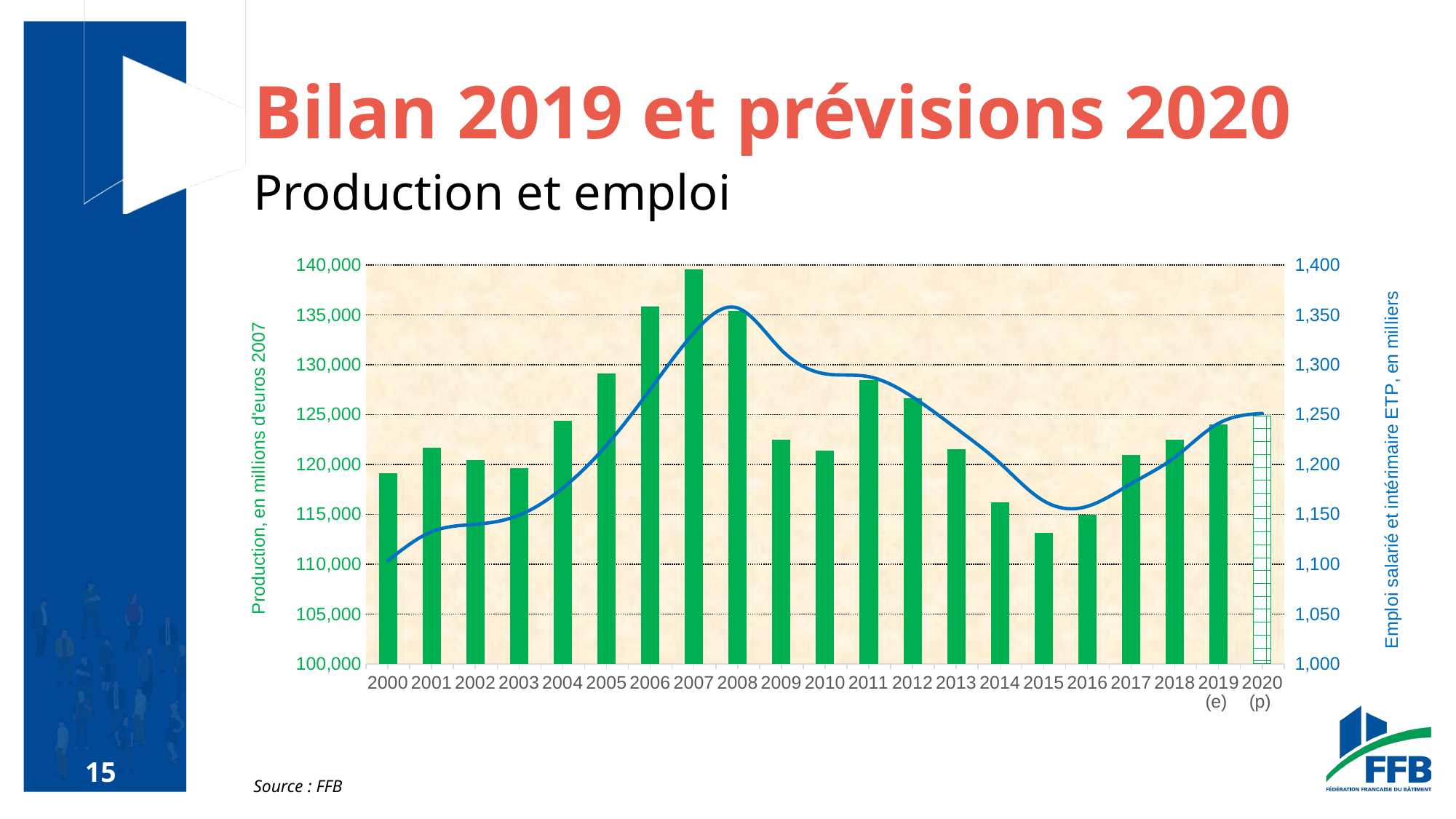
What kind of chart is shown on the slide? A bar chart combined with a line What is the title of the left vertical axis? Production, en millions d'euros 2007 What is the title of the right vertical axis? Emploi salarié et intérimaire ETP, en milliers Is the employment line value for 2016 greater or less than 1,200? less Do the production bars rise or fall from 2012 to 2015? fall Which year has the lowest production bar? 2015 Which year has the highest production bar? 2007 Is the production value for 2000 greater or less than 120,000? less Is the production value for 2007 greater or less than 135,000? greater Which year has the larger production bar, 2007 or 2008? 2007 How many years are shown on the x axis of the chart? 21